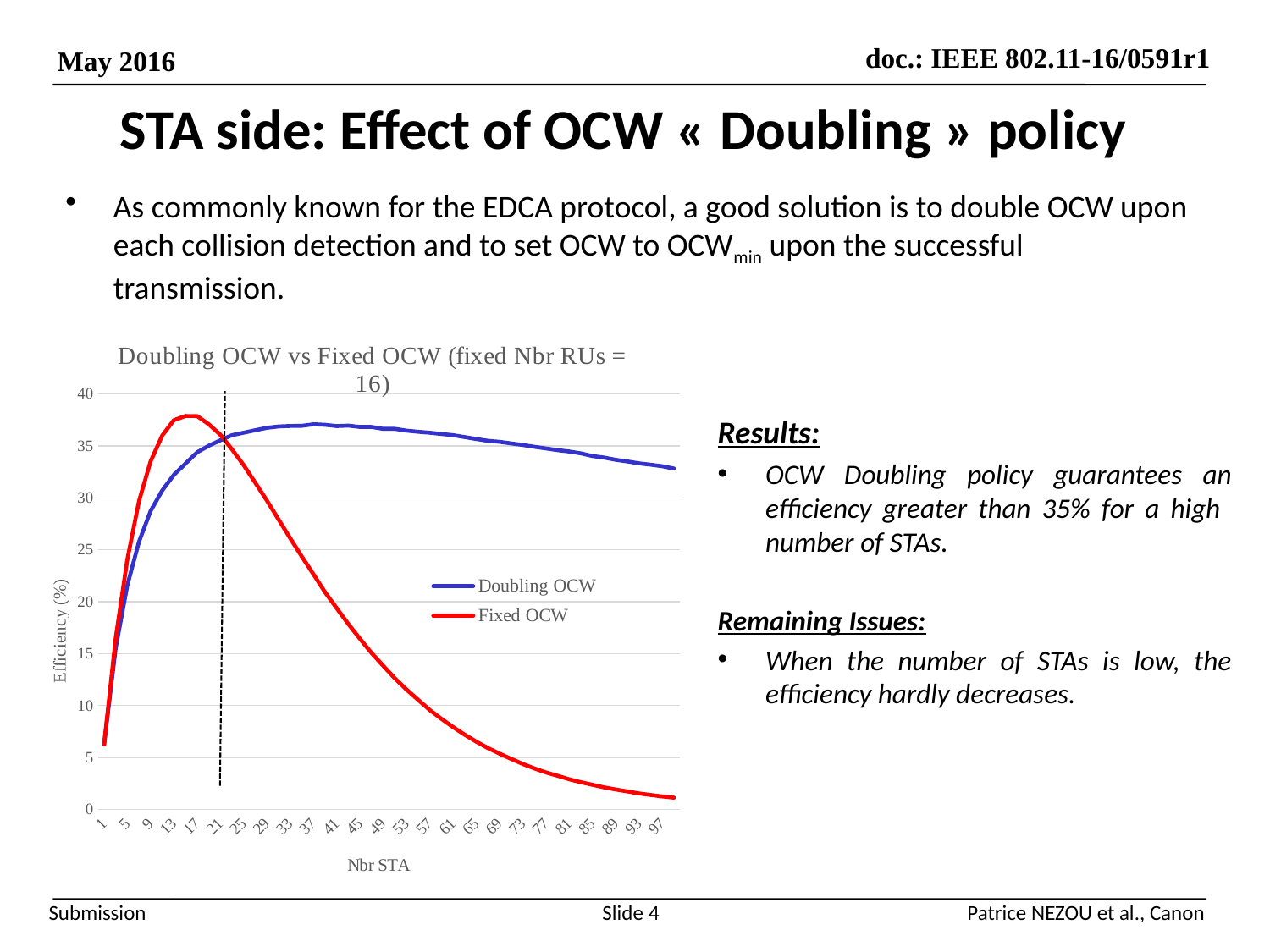
What are the two series named in the chart's legend? Doubling OCW and Fixed OCW How many series does the chart's legend list? 2 What is the title of the chart? Doubling OCW vs Fixed OCW (fixed Nbr RUs = 16) Is the value of the Fixed OCW series at Nbr STA 97 greater or less than 5? less At Nbr STA 61, which series has the higher efficiency, Doubling OCW or Fixed OCW? Doubling OCW What kind of chart is shown on the slide? line chart At Nbr STA 13, which series has the higher efficiency, Doubling OCW or Fixed OCW? Fixed OCW Is the peak value of the Fixed OCW series greater or less than 35? greater Is the value of the Doubling OCW series at Nbr STA 97 greater or less than 30? greater Does the Doubling OCW series rise or fall as Nbr STA increases from 1 to 37? rise Does the Fixed OCW series rise or fall as Nbr STA increases from 17 to 97? fall